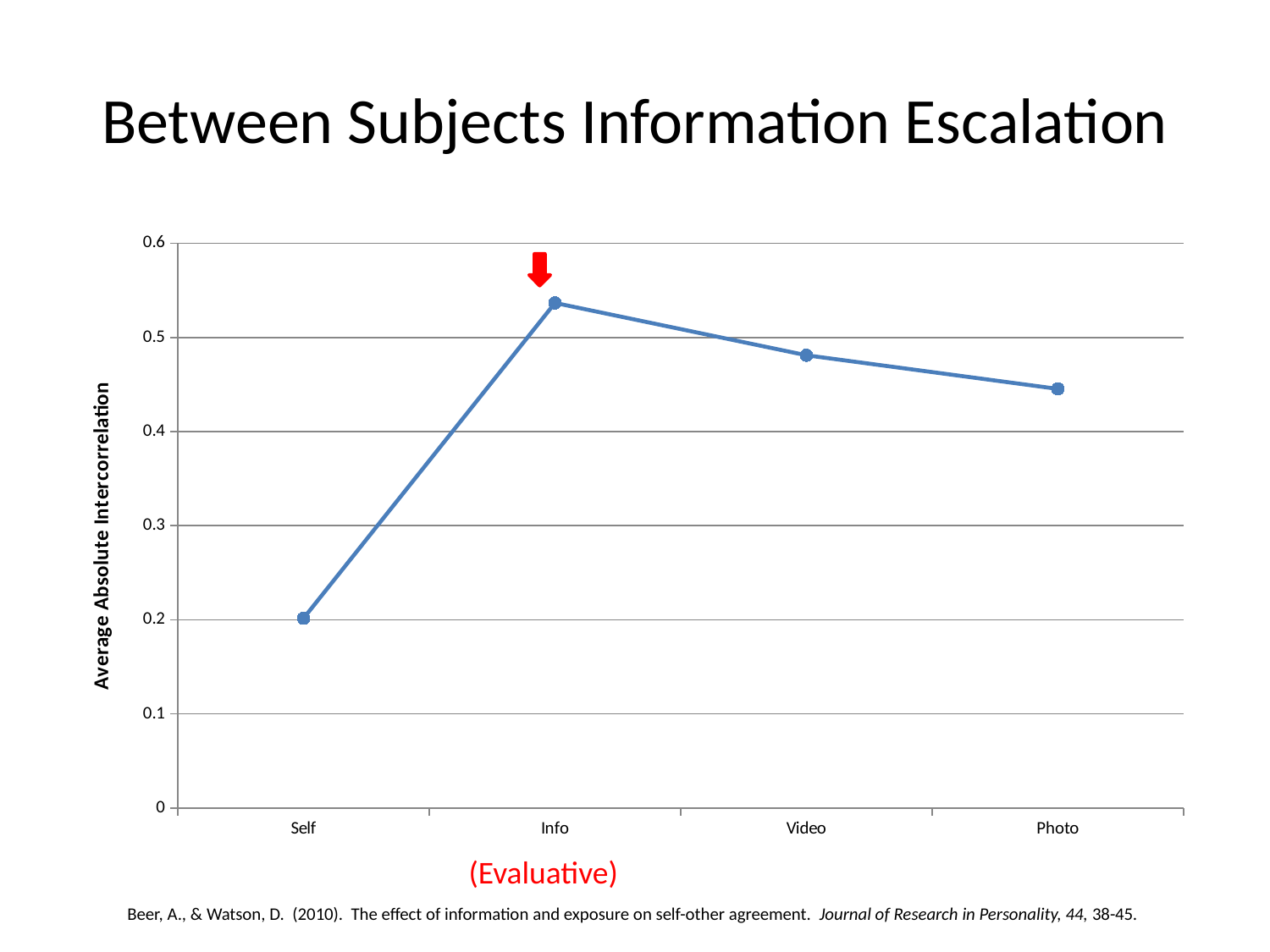
Which category has the lowest average absolute intercorrelation? Self Do the values rise or fall from Info to Photo? fall Which category has the highest average absolute intercorrelation? Info How many categories are plotted along the x axis? 4 What kind of chart is shown on the slide? line chart Is the value for Self greater or less than 0.3? less What is the label on the y axis? Average Absolute Intercorrelation Which has a higher value, Video or Photo? Video Is the value for Photo greater or less than 0.4? greater Which has a higher value, Info or Video? Info Is the value for Info greater or less than 0.5? greater